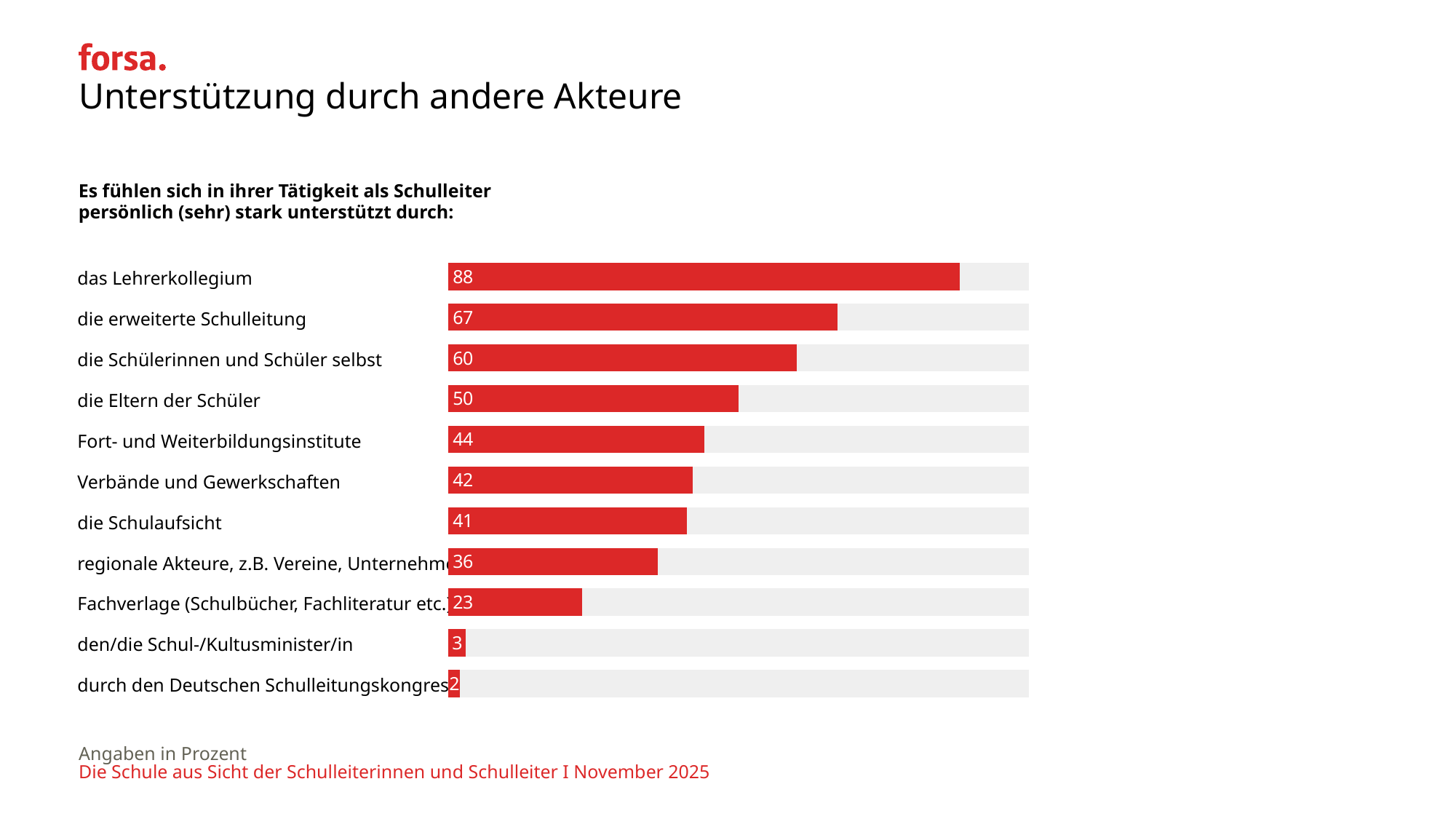
Which has a larger value, "Fort- und Weiterbildungsinstitute" or "Verbände und Gewerkschaften"? Fort- und Weiterbildungsinstitute How many categories are shown in the chart? 11 What is the difference between the values for "die erweiterte Schulleitung" and "die Schülerinnen und Schüler selbst"? 7 What is the value for "das Lehrerkollegium"? 88 What is the value for "den/die Schul-/Kultusminister/in"? 3 Which category has the lowest value? durch den Deutschen Schulleitungskongress What is the value for "die Schulaufsicht"? 41 What is the value for "die Eltern der Schüler"? 50 Which category has the highest value? das Lehrerkollegium What is the difference between the values for "das Lehrerkollegium" and "Fachverlage (Schulbücher, Fachliteratur etc.)"? 65 What kind of chart is shown on the slide? bar chart What is the title of the slide? Unterstützung durch andere Akteure